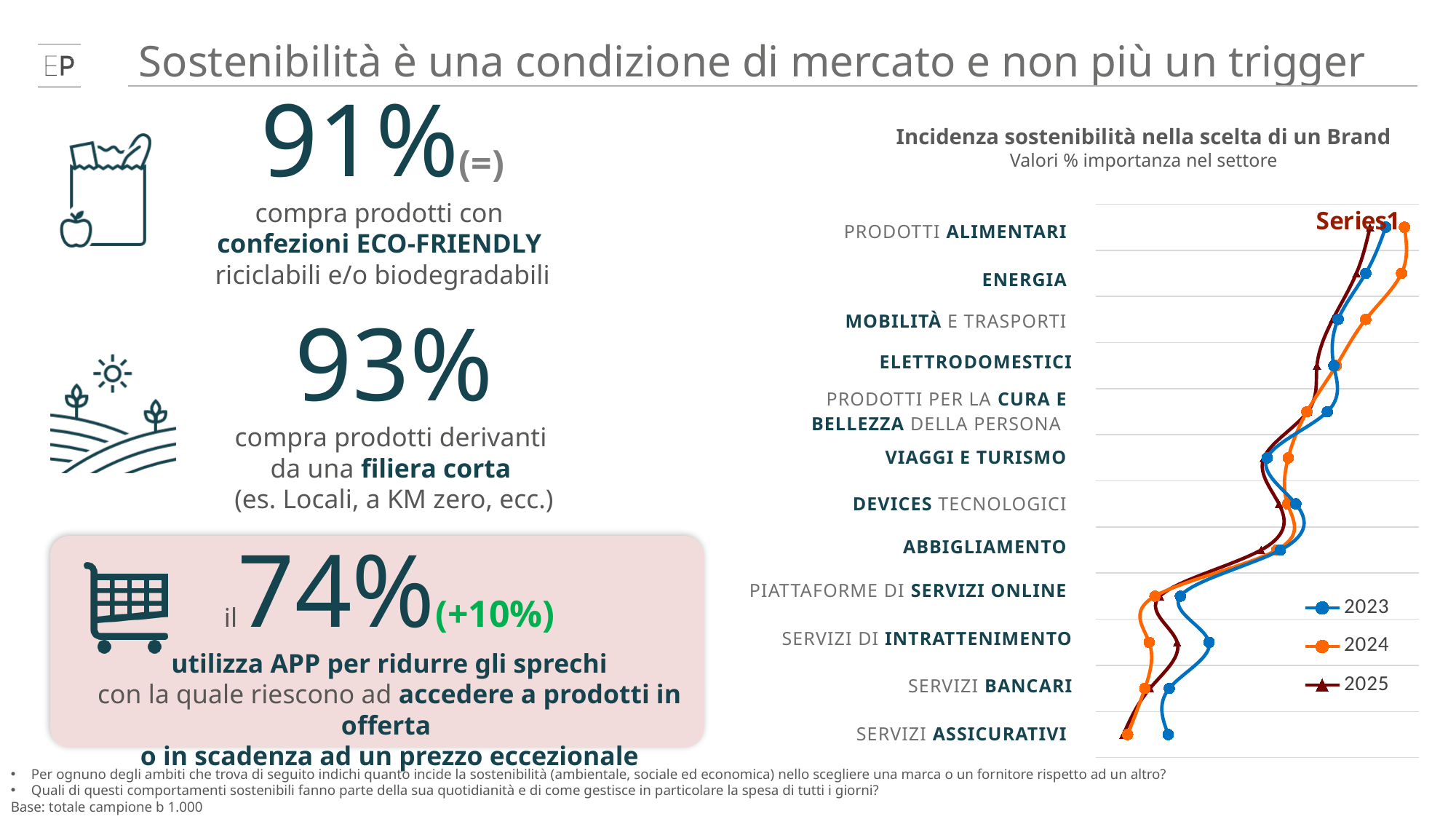
How many series does the chart legend list? 3 Which years are listed in the chart legend? 2023, 2024, 2025 For the 2024 series, which category has the highest value? Prodotti alimentari For the 2024 series, which category has the lowest value? Servizi assicurativi At Energia, which series has the larger value, 2024 or 2025? 2024 Moving down the category list from Prodotti alimentari to Servizi assicurativi, do the values generally rise or fall? fall What is the title of the chart on the right of the slide? Incidenza sostenibilità nella scelta di un Brand At Servizi di intrattenimento, which series has the larger value, 2023 or 2024? 2023 For the 2023 series, which category has the highest value? Prodotti alimentari For the 2025 series, which category has the lowest value? Servizi assicurativi How many categories (sectors) are plotted on the chart? 12 What kind of chart is shown on the right of the slide? line chart